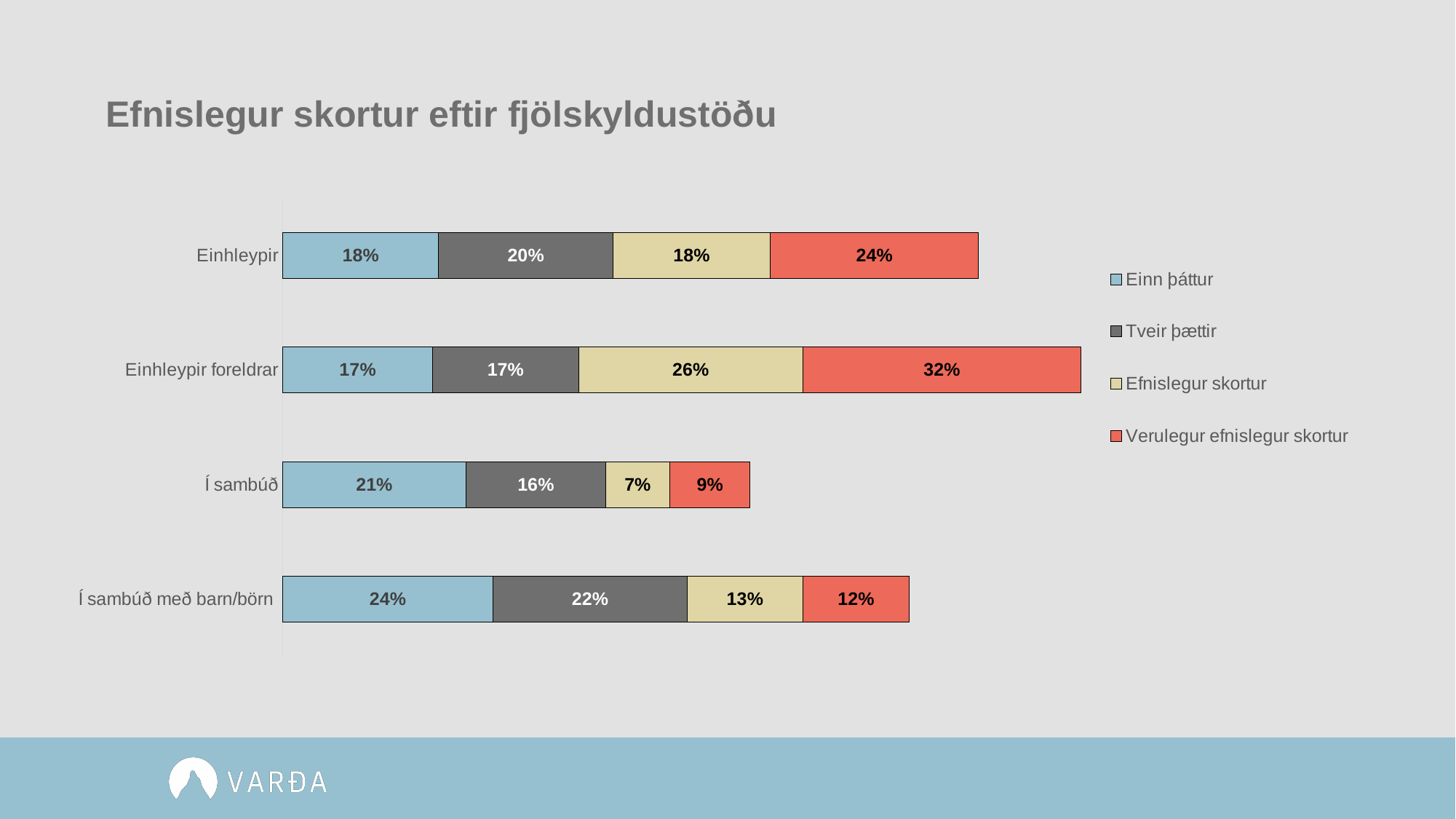
What kind of chart is shown on the slide? Stacked bar chart Which category has the lowest value for "Efnislegur skortur"? Í sambúð How many series does the legend list? 4 What is the total of the stacked bar for Í sambúð? 53% Which category has the highest value for "Verulegur efnislegur skortur"? Einhleypir foreldrar Which is larger: the "Tveir þættir" value for Einhleypir or for Í sambúð með barn/börn? Í sambúð með barn/börn What is the value for "Einn þáttur" for Í sambúð með barn/börn? 24% What is the difference between the "Verulegur efnislegur skortur" values for Einhleypir foreldrar and Í sambúð? 23% What is the value for "Efnislegur skortur" for Í sambúð? 7% What is the total of the stacked bar for Einhleypir foreldrar? 92% What is the value for "Verulegur efnislegur skortur" for Einhleypir foreldrar? 32% How many categories are shown on the chart? 4